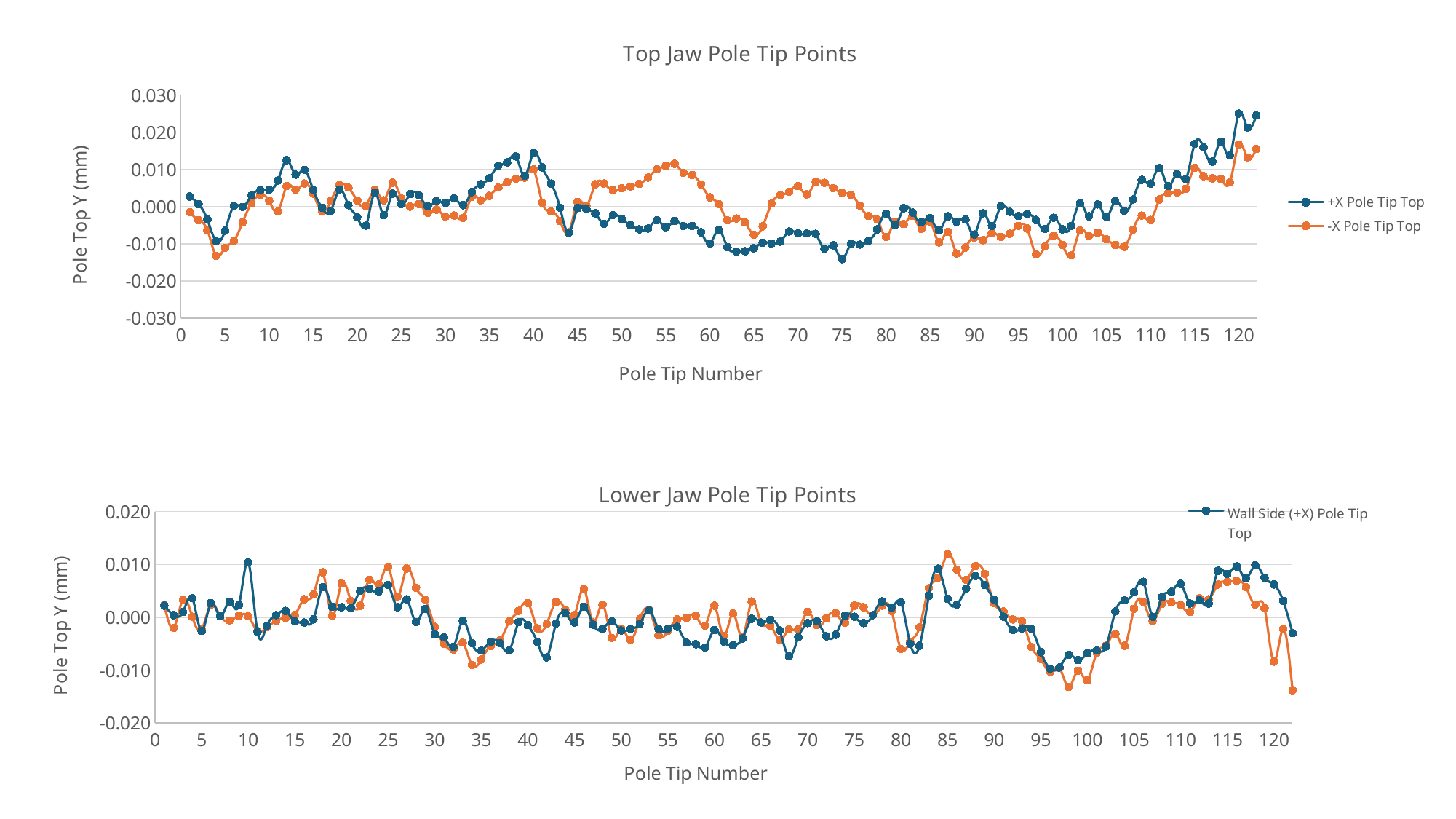
What kind of chart is the 'Top Jaw Pole Tip Points' chart? line chart In the 'Top Jaw Pole Tip Points' chart, is the value of '-X Pole Tip Top' at pole tip number 56 greater or less than 0.010? greater In the 'Lower Jaw Pole Tip Points' chart, what is the label of the x axis? Pole Tip Number In the 'Top Jaw Pole Tip Points' chart, is the value of '-X Pole Tip Top' at pole tip number 4 greater or less than -0.010? less In the 'Top Jaw Pole Tip Points' chart, what is the label of the y axis? Pole Top Y (mm) In the 'Lower Jaw Pole Tip Points' chart, is the value of the orange series at pole tip number 122 greater or less than -0.010? less In the 'Top Jaw Pole Tip Points' chart, which series reaches the highest value on the chart? +X Pole Tip Top What kind of chart is the 'Lower Jaw Pole Tip Points' chart? line chart In the 'Top Jaw Pole Tip Points' chart, do the values of '+X Pole Tip Top' generally rise or fall between pole tip number 100 and 120? rise In the 'Top Jaw Pole Tip Points' chart, how many series does the legend list? 2